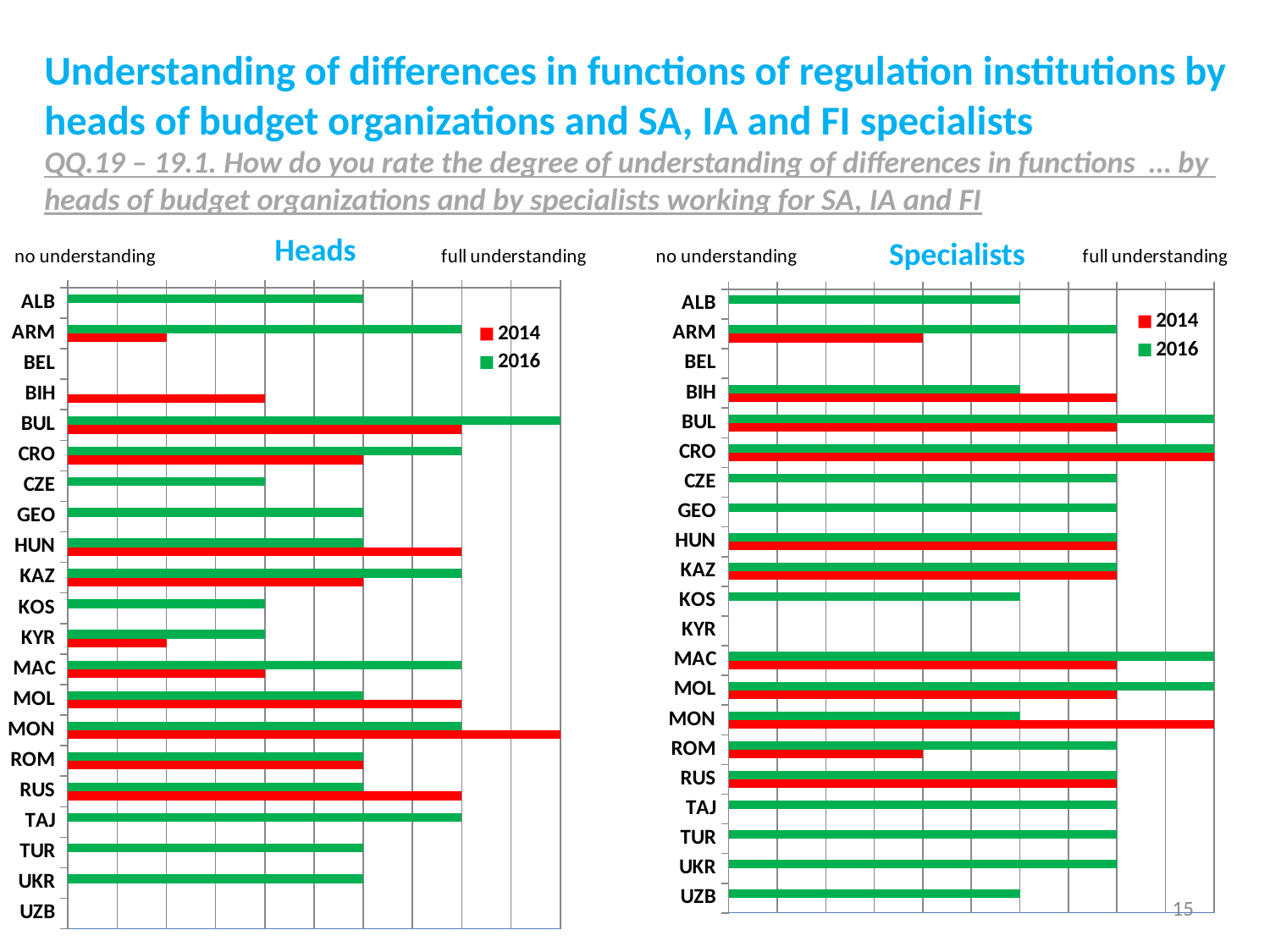
How many country categories are shown on the "Heads" chart? 21 In the "Heads" chart, for ARM, which year has the larger value, 2014 or 2016? 2016 In the "Specialists" chart, for BIH, which year has the larger value, 2014 or 2016? 2014 In the "Heads" chart, which country has the longest 2016 bar? BUL In the "Heads" chart, for HUN, which year has the larger value, 2014 or 2016? 2014 What kind of chart is the "Heads" chart? bar chart How many series does the legend of the "Specialists" chart list? 2 In the "Heads" chart, which country has the longest 2014 bar? MON What colour represents the 2016 series in the "Heads" chart? green